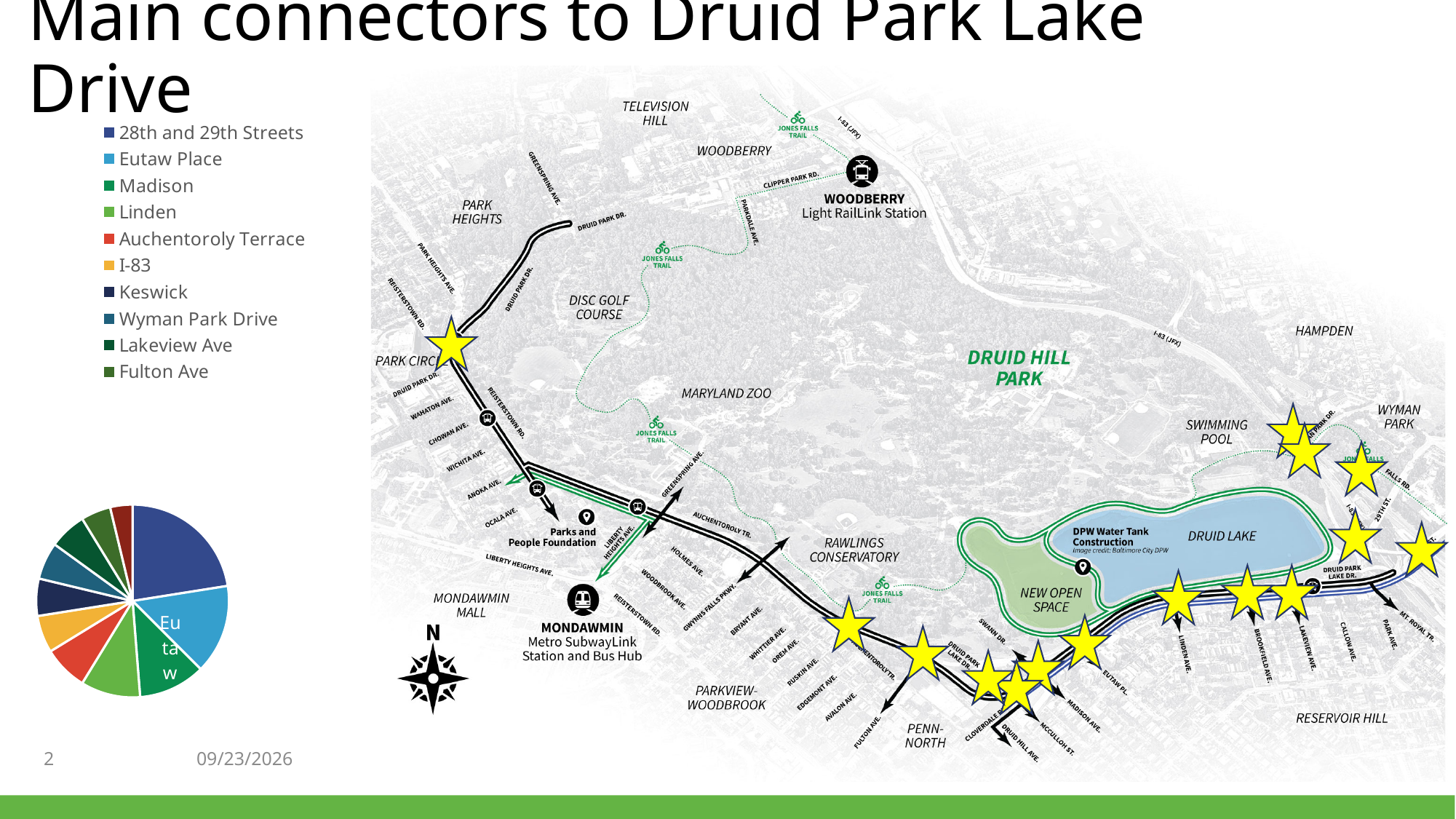
How many entries does the legend of the pie chart list? 10 What is the last entry listed in the pie chart's legend? Fulton Ave What kind of chart is shown on the slide? pie chart Which slice is larger in the pie chart, Madison or Fulton Ave? Madison What is the first entry listed in the pie chart's legend? 28th and 29th Streets Which slice is larger in the pie chart, Eutaw Place or Wyman Park Drive? Eutaw Place Which slice is larger in the pie chart, 28th and 29th Streets or Eutaw Place? 28th and 29th Streets Which category has the largest slice in the pie chart? 28th and 29th Streets